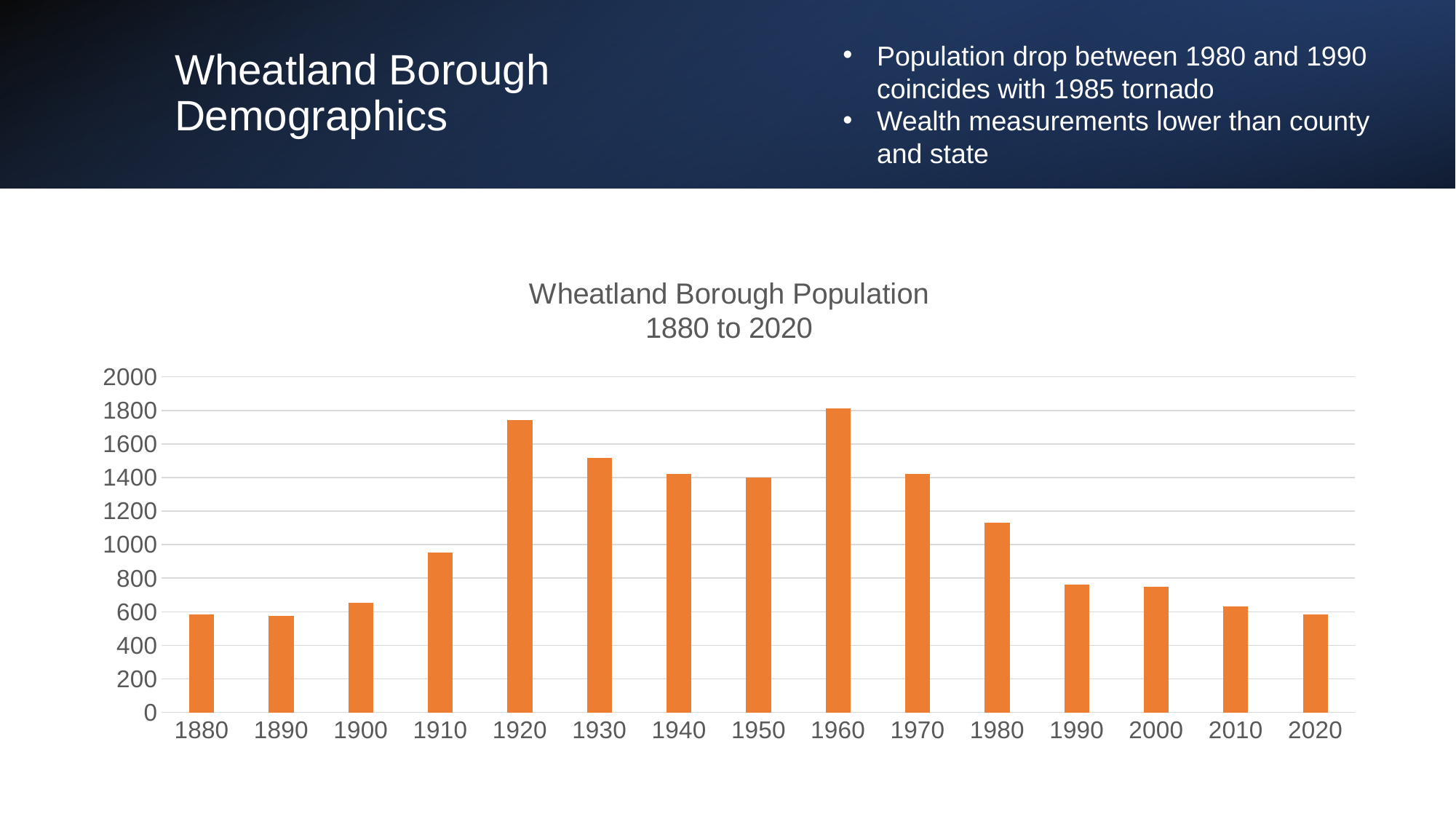
Which year has the highest population on the chart? 1960 What is the title of the chart? Wheatland Borough Population 1880 to 2020 Do the population values rise or fall from 1960 to 2020? fall Is the population value for 1980 greater or less than 1000? greater Is the population value for 1990 greater or less than 800? less How many years (bars) are plotted on the chart? 15 Is the population value for 1910 greater or less than 1000? less Which year has the larger population, 1920 or 1930? 1920 What kind of chart is shown on the slide? bar chart Which year has the larger population, 1910 or 1980? 1980